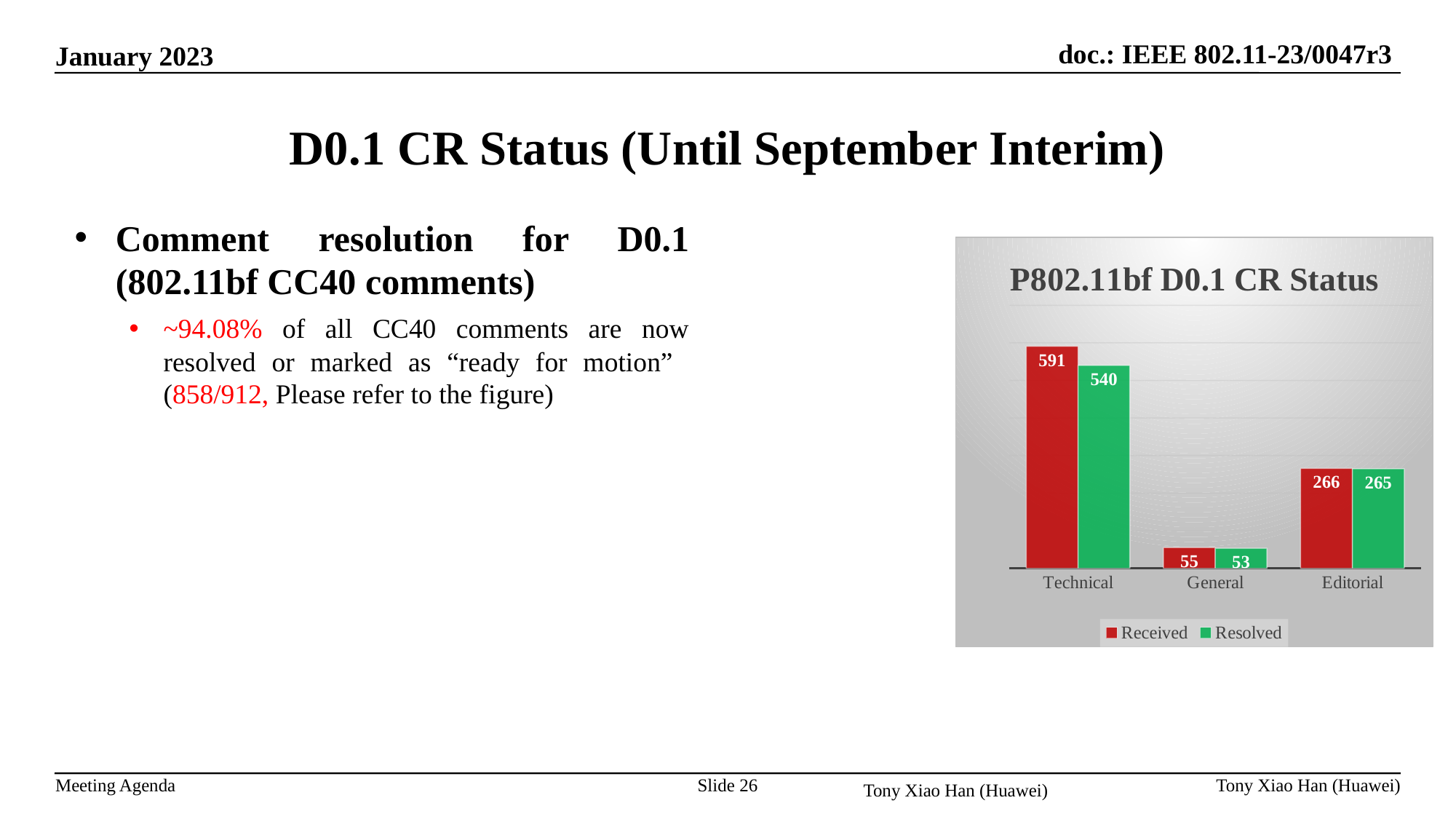
How many series does the legend list? 2 What is the Received value for Technical? 591 How many categories are shown on the x axis? 3 Which category has the lowest Resolved value? General What is the title of the chart? P802.11bf D0.1 CR Status Which is larger, the Received value for Editorial or the Received value for General? Editorial What is the Resolved value for Technical? 540 What is the difference between Received and Resolved for Technical? 51 What is the difference between Received and Resolved for General? 2 What is the Resolved value for Editorial? 265 What is the Received value for General? 55 Which category has the highest Received value? Technical